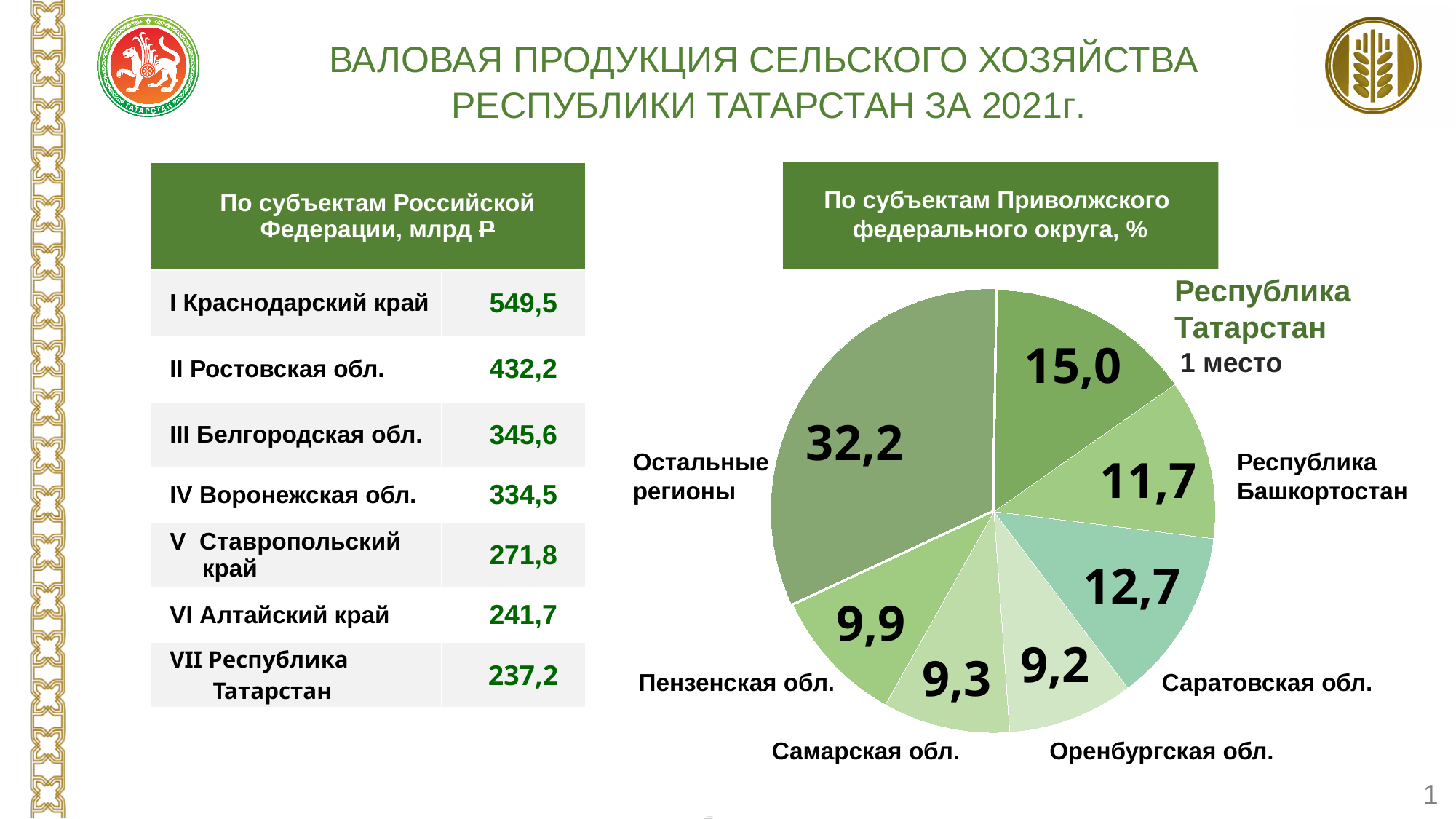
In the pie chart, how much larger is the value for Республика Татарстан than for Республика Башкортостан? 3,3 What is the title of the pie chart? По субъектам Приволжского федерального округа, % Which slice of the pie chart is the largest? Остальные регионы In the pie chart, what share does Республика Татарстан have? 15,0 In the pie chart, what is the value for Пензенская обл.? 9,9 Which slice of the pie chart is the smallest? Оренбургская обл. In the pie chart, what is the difference between Остальные регионы and Республика Татарстан? 17,2 In the pie chart, what is the value for Республика Башкортостан? 11,7 What kind of chart is shown on the right side of the slide? pie chart In the pie chart, what is the value for Саратовская обл.? 12,7 In the pie chart, which is larger: Самарская обл. or Оренбургская обл.? Самарская обл. How many slices does the pie chart have? 7